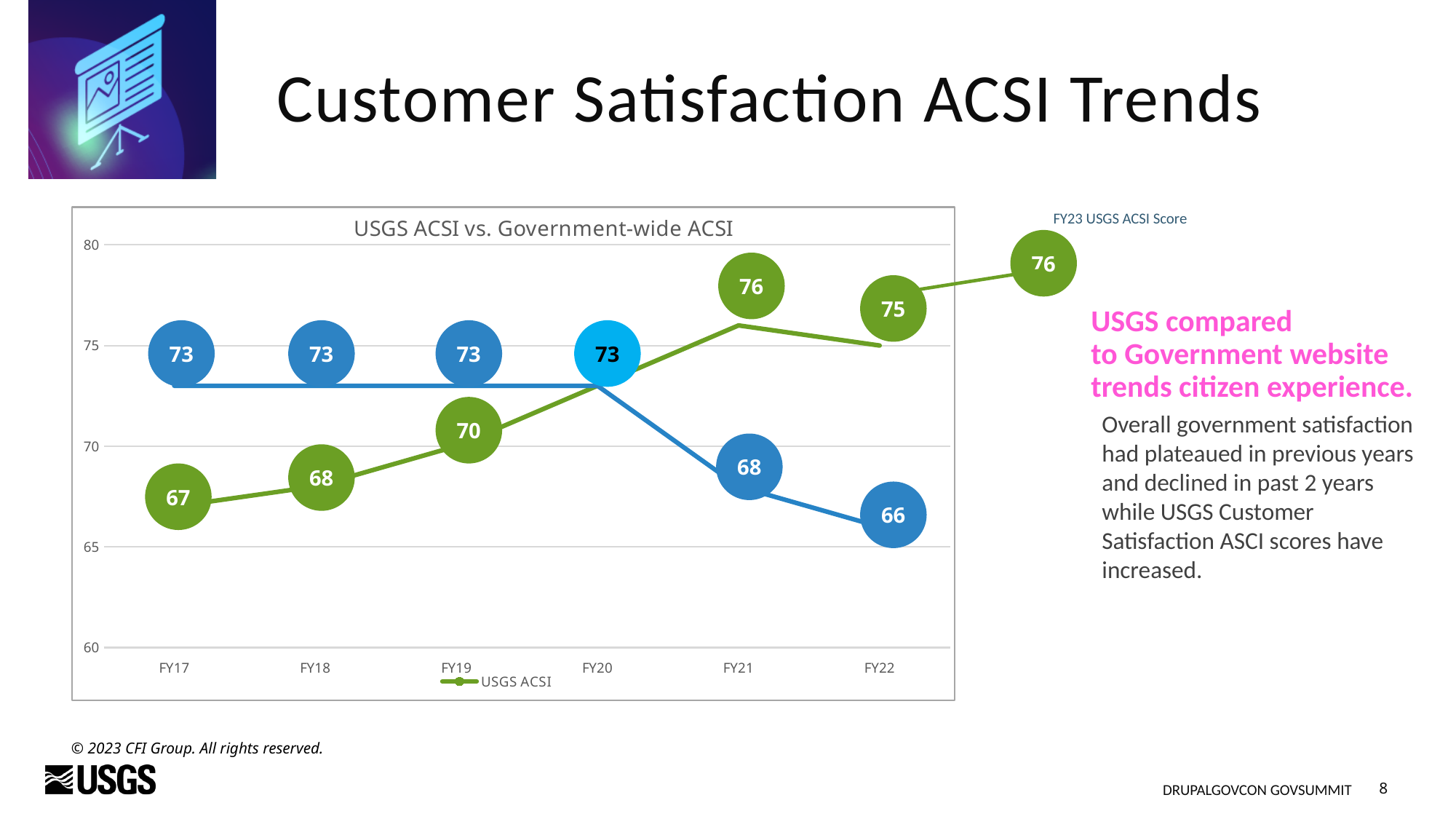
What is the USGS ACSI value for FY21? 76 What is the USGS ACSI value for FY17? 67 In FY19, which line has the larger value, the green USGS ACSI line or the blue Government-wide line? the blue Government-wide line In which fiscal year is the USGS ACSI (green line) lowest? FY17 How many fiscal years are shown on the x axis of the chart? 6 In which fiscal year is the USGS ACSI (green line) highest? FY21 What is the difference between the green USGS ACSI value and the blue Government-wide value in FY22? 9 What is the title of the chart? USGS ACSI vs. Government-wide ACSI What kind of chart is shown on the slide? line chart Does the blue Government-wide line rise or fall from FY20 to FY22? fall How many series does the chart legend list? 1 What is the value of the blue (Government-wide) line for FY22? 66